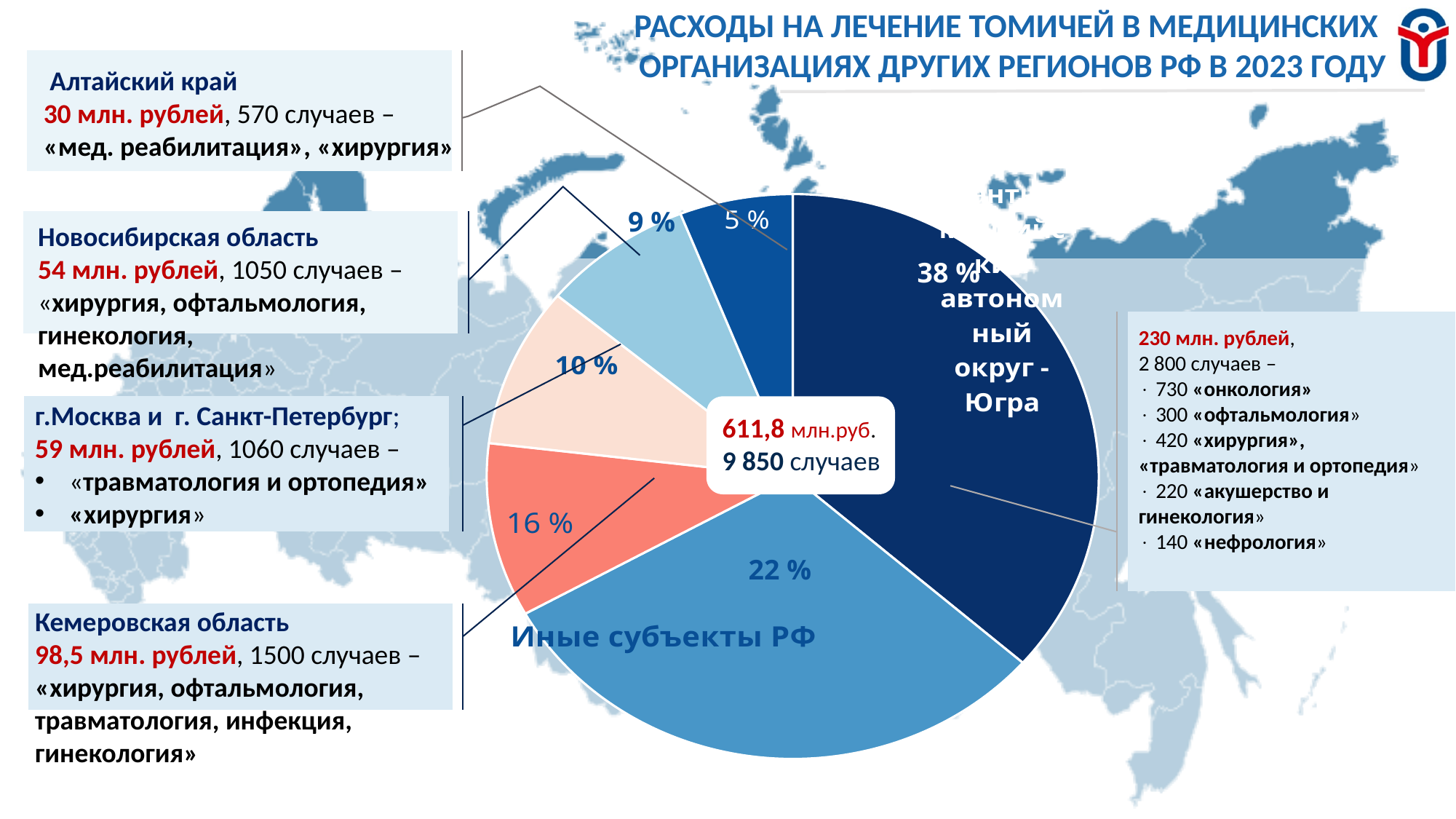
What total amount in million rubles is shown in the centre of the pie chart? 611,8 млн.руб. How many slices does the pie chart have? 6 What share of the pie corresponds to Новосибирская область? 9 % Which is larger: the share for Кемеровская область or the share for Новосибирская область? Кемеровская область What kind of chart is shown on the slide? pie chart What is the difference in percentage points between the 38 % slice and the 22 % slice? 16 percentage points Which slice of the pie chart has the smallest share? Алтайский край (5 %) Which slice of the pie chart has the largest share? Ханты-Мансийский автономный округ - Югра (38 %) What share of the pie is labelled for «Иные субъекты РФ»? 22 % What share of the pie corresponds to Кемеровская область? 16 % How many cases in total are shown in the centre of the pie chart? 9 850 случаев